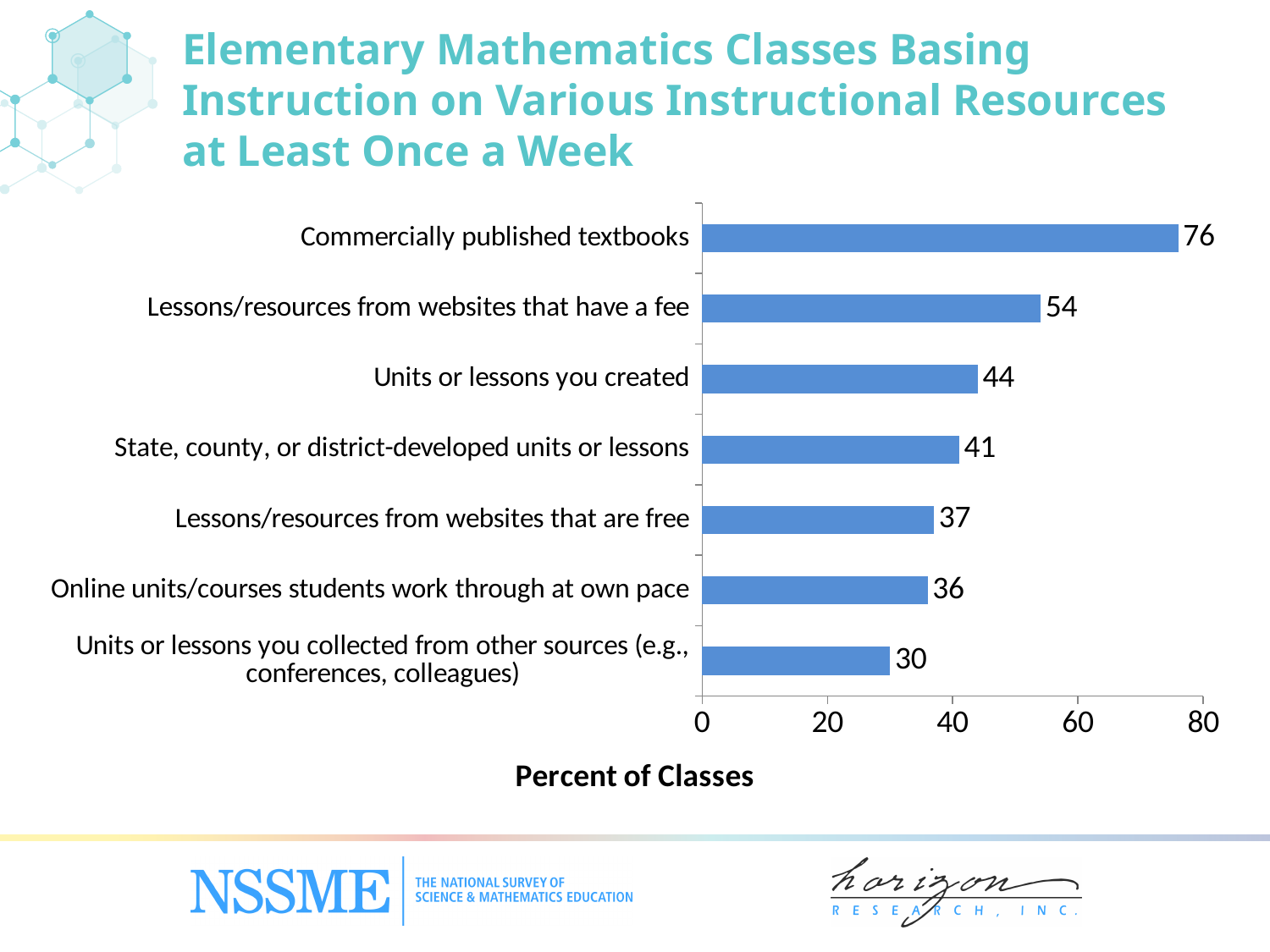
What is the value for Units or lessons you created? 44 What is the label of the horizontal axis? Percent of Classes What is the value for Online units/courses students work through at own pace? 36 Which category has the lowest value? Units or lessons you collected from other sources (e.g., conferences, colleagues) Is the value for Units or lessons you created greater or less than 40? greater What is the value for Lessons/resources from websites that have a fee? 54 What is the difference between the values for Commercially published textbooks and Lessons/resources from websites that have a fee? 22 What kind of chart is shown on the slide? Bar chart What is the value for Commercially published textbooks? 76 Which category has the highest value? Commercially published textbooks How many categories are shown in the chart? 7 Which is larger: the value for Lessons/resources from websites that are free or the value for State, county, or district-developed units or lessons? State, county, or district-developed units or lessons